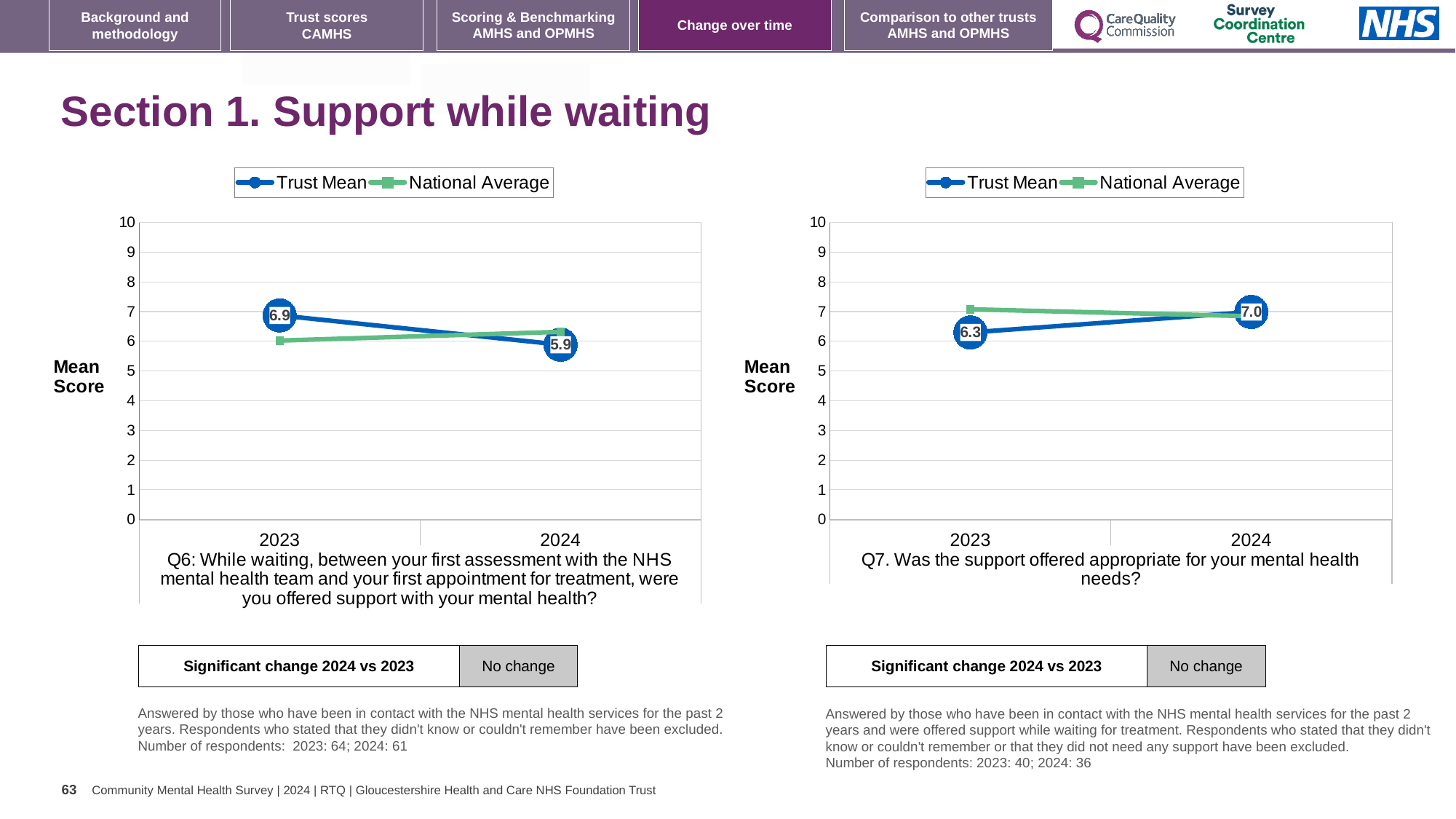
In the Q6 chart on the left, by how much did the Trust Mean fall from 2023 to 2024? 1.0 In the Q7 chart on the right, by how much did the Trust Mean rise from 2023 to 2024? 0.7 In the Q6 chart on the left, which is higher in 2023, the Trust Mean or the National Average? Trust Mean In the Q6 chart on the left, what is the Trust Mean for 2024? 5.9 In the Q7 chart on the right, which is higher in 2023, the Trust Mean or the National Average? National Average In the Q7 chart on the right, does the Trust Mean rise or fall from 2023 to 2024? rise In the Q7 chart on the right, what is the Trust Mean for 2024? 7.0 In the Q6 chart on the left, does the Trust Mean rise or fall from 2023 to 2024? fall How many series does the legend of the Q6 chart on the left list? 2 In the Q6 chart on the left, what is the Trust Mean for 2023? 6.9 In the Q7 chart on the right, what is the Trust Mean for 2023? 6.3 In the Q7 chart on the right, is the National Average for 2023 greater or less than 8? less